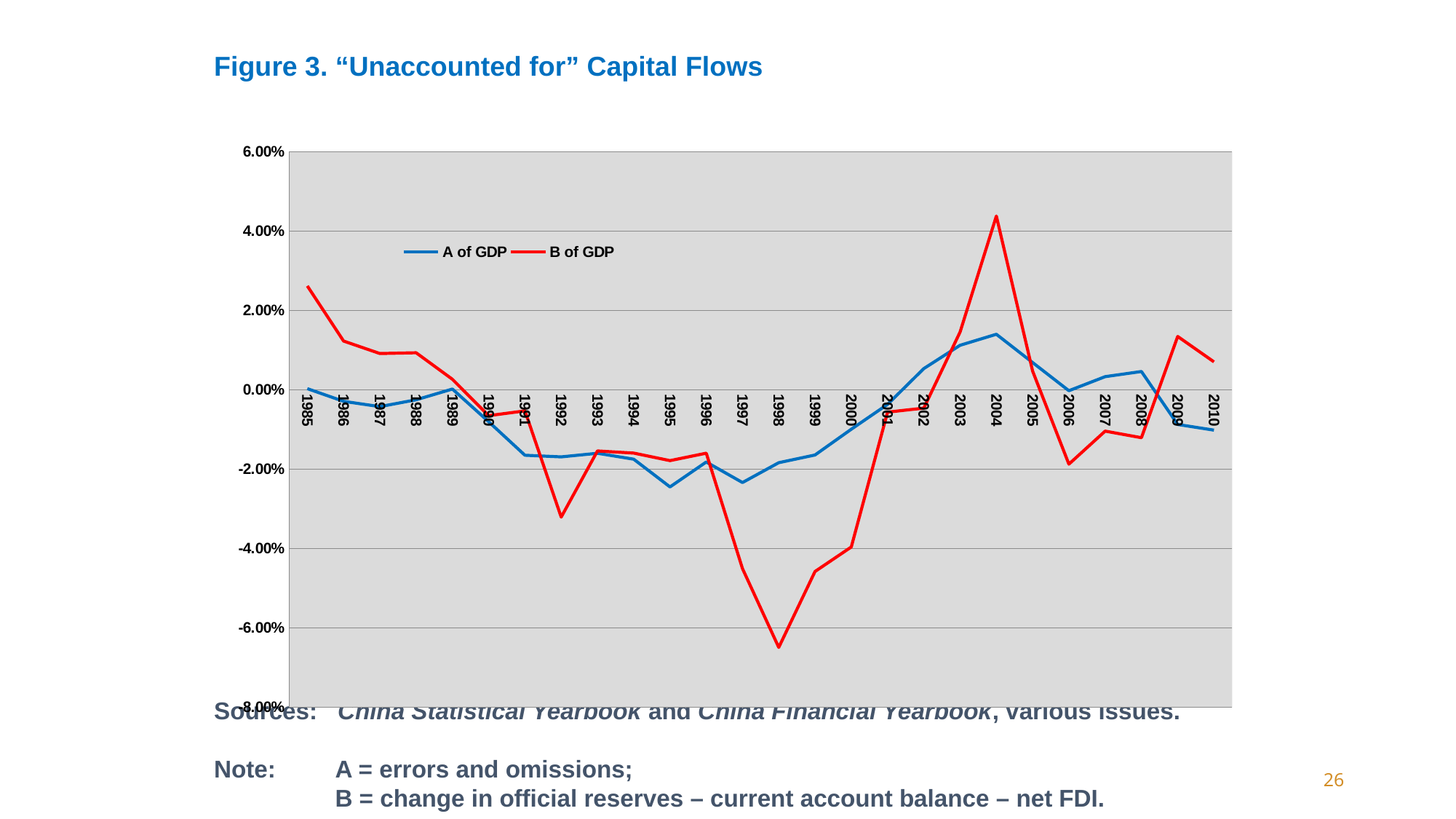
Is the value of A of GDP in 1995 greater or less than -2.00%? less In 1998, which series has the higher value, A of GDP or B of GDP? A of GDP In which year does the A of GDP series reach its highest value? 2004 In which year does the B of GDP series reach its highest value? 2004 Is the value of B of GDP in 1998 greater or less than -6.00%? less How many years are plotted along the x axis? 26 What kind of chart is shown on the slide? Line chart What are the two series named in the legend? A of GDP and B of GDP Is the value of B of GDP in 1985 greater or less than 2.00%? greater Does the B of GDP series rise or fall from 1985 to 1990? Fall How many series does the legend list? 2 In which year does the B of GDP series reach its lowest value? 1998